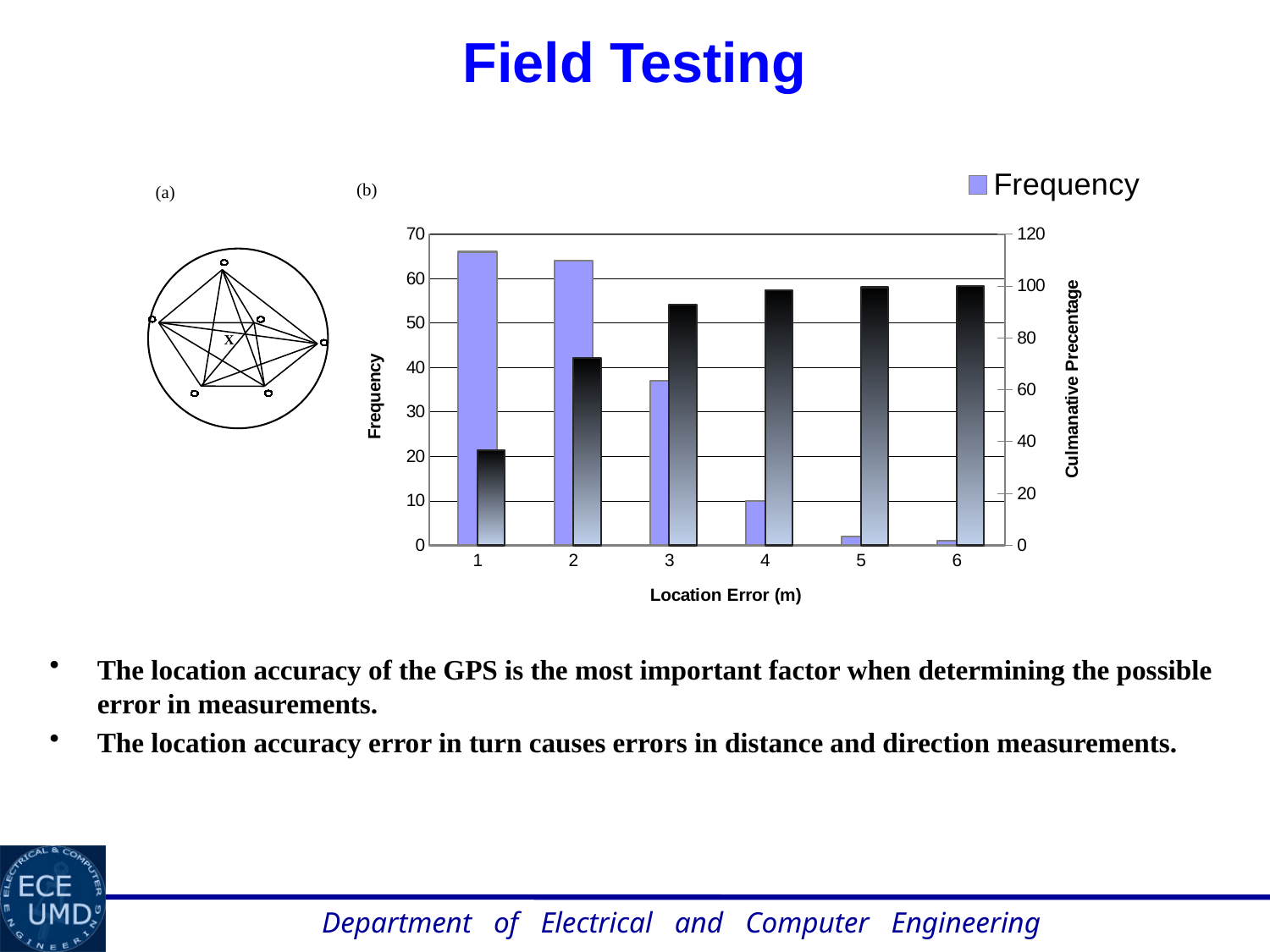
How many series does the chart's legend list? 1 Which has the larger Frequency value, location error 2 or location error 3? 2 Is the cumulative percentage for location error 2 greater or less than 60? greater Is the Frequency value for location error 1 greater or less than 60? greater Do the Frequency values rise or fall as location error increases from 1 to 6? fall What kind of chart is shown on the slide? bar chart Do the cumulative percentage bars rise or fall as location error increases from 1 to 6? rise What is the title of the right-hand vertical axis of the chart? Culmanative Precentage Is the Frequency value for location error 4 greater or less than 20? less How many location error categories are shown on the x axis of the chart? 6 What is the title of the x axis of the chart? Location Error (m)